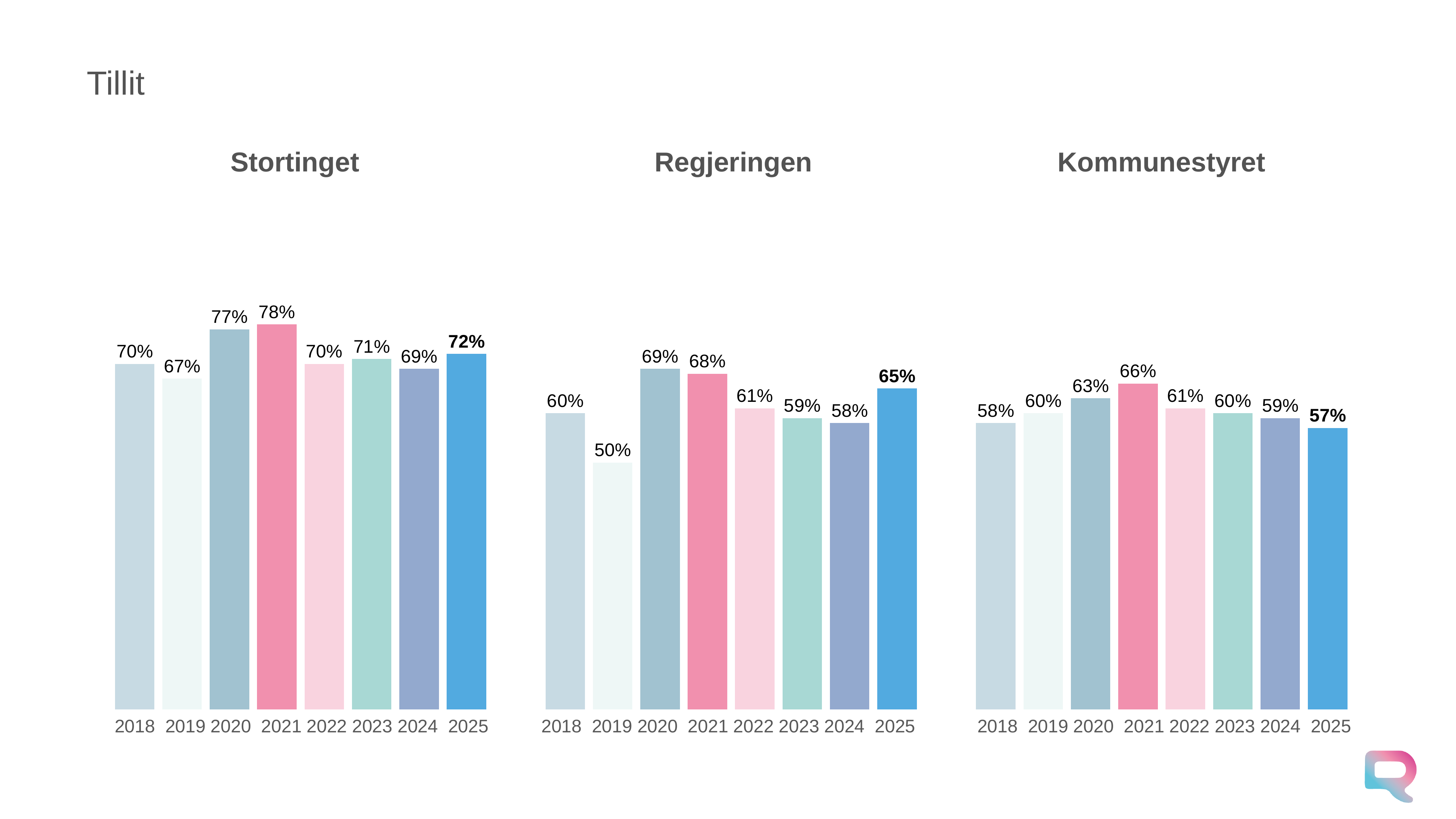
In the Stortinget chart, what is the value for 2021? 78% In the Kommunestyret chart, what is the difference between the 2021 value and the 2018 value? 8% What is the title of the slide? Tillit What kind of chart is the Stortinget chart? Bar chart How many years are shown in the Regjeringen chart? 8 In the Regjeringen chart, which year has the lowest value? 2019 In the Stortinget chart, which is larger, the value for 2020 or the value for 2022? 2020 In the Kommunestyret chart, what is the value for 2025? 57% In the Stortinget chart, which year has the highest value? 2021 In the Regjeringen chart, what is the difference between the 2025 value and the 2024 value? 7% In the Kommunestyret chart, which year has the highest value? 2021 In the Regjeringen chart, what is the value for 2019? 50%